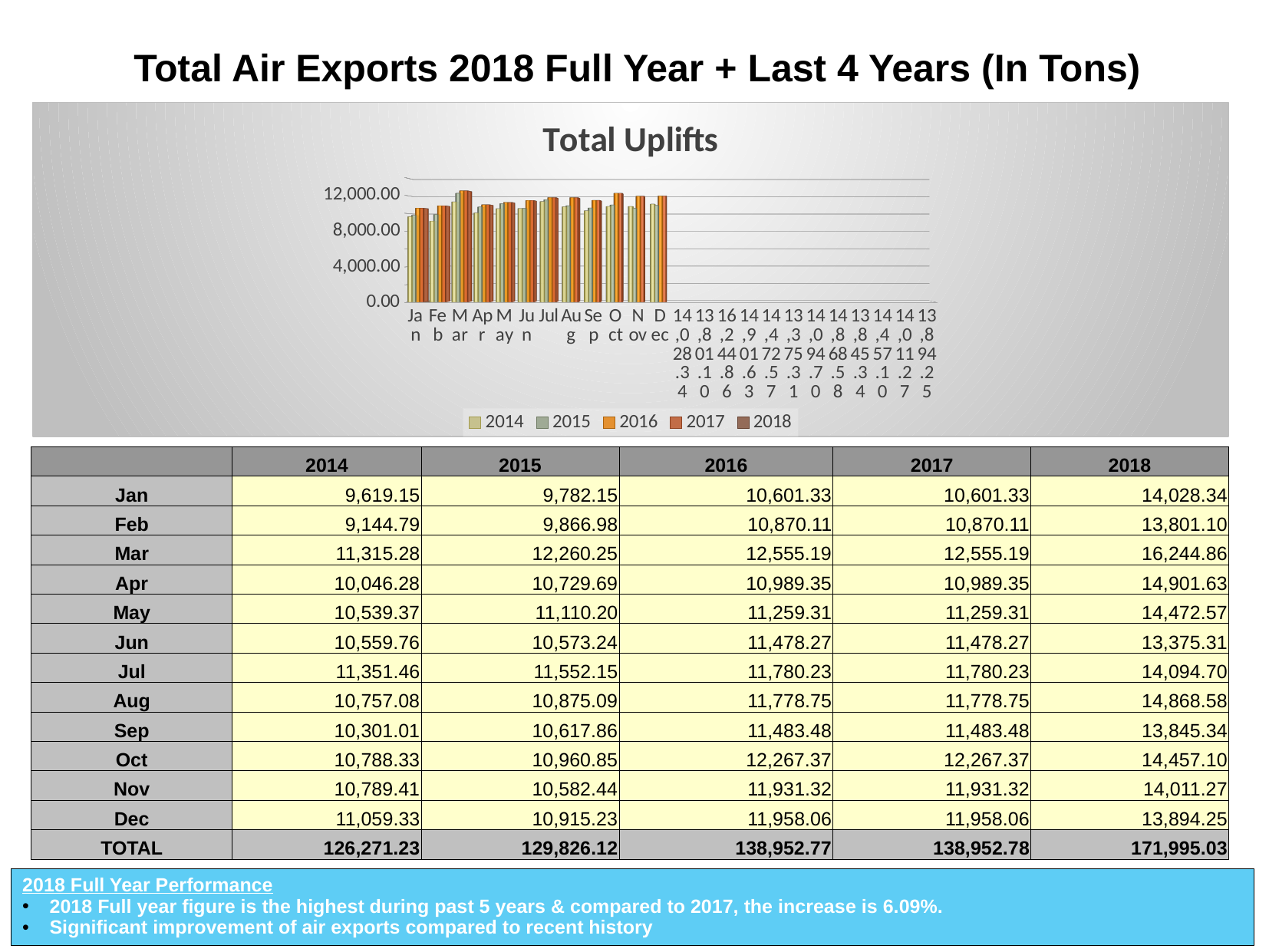
Is the value for Feb 2014 greater or less than 12,000? less What kind of chart is shown on the slide? bar chart What is the title of the chart? Total Uplifts Is the value for Jan 2014 greater or less than 8,000? greater What is the difference between the 2018 TOTAL and the 2017 TOTAL? 33,042.25 What is the highest value shown on the chart's vertical axis? 12,000.00 According to the table, what is the value for Mar 2018? 16,244.86 Which month has the lowest value in 2014? Feb According to the table, what is the TOTAL for 2018? 171,995.03 Which years are listed in the chart legend? 2014, 2015, 2016, 2017, 2018 Which month has the highest value in 2018? Mar How many series does the chart legend list? 5